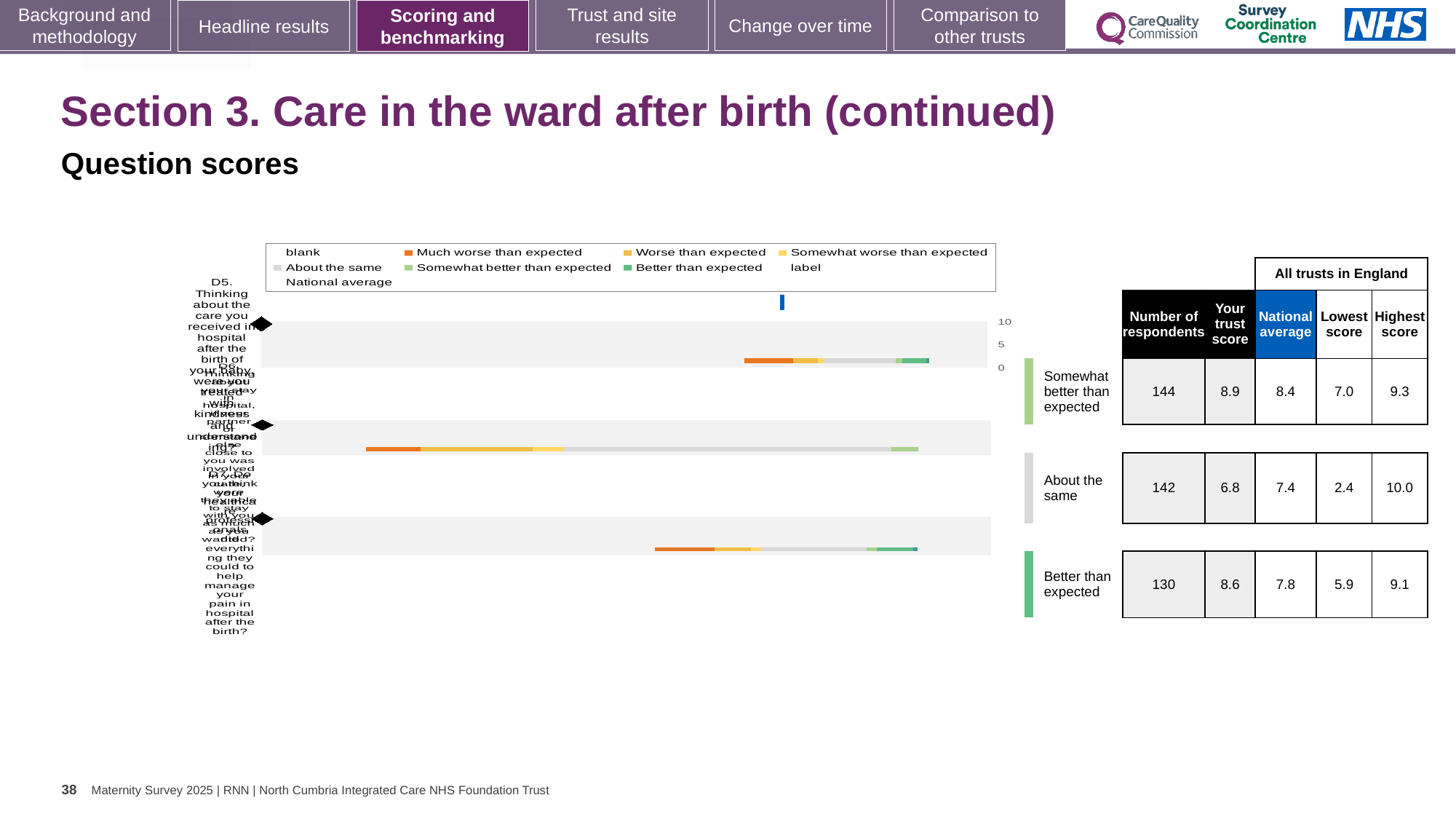
In the table beside the chart, which row has the highest 'Your trust score'? Somewhat better than expected In the table beside the chart, for the 'About the same' row, which is larger: the trust score or the national average? national average In the table beside the chart, what is the number of respondents for the 'Somewhat better than expected' row? 144 How many bars (questions) are plotted in the chart? 3 In the table beside the chart, what is the national average for the 'Better than expected' row? 7.8 How many entries does the chart legend list? 9 What colour does the legend use for 'Much worse than expected'? orange In the table beside the chart, what is the difference between the trust score (8.9) and the national average (8.4) for the 'Somewhat better than expected' row? 0.5 In the table beside the chart, which row has the lowest 'Lowest score' value? About the same What kind of chart is shown on the slide? bar chart In the table beside the chart, what is the 'Your trust score' for the 'About the same' row? 6.8 What is the highest tick value shown on the chart's axis? 10